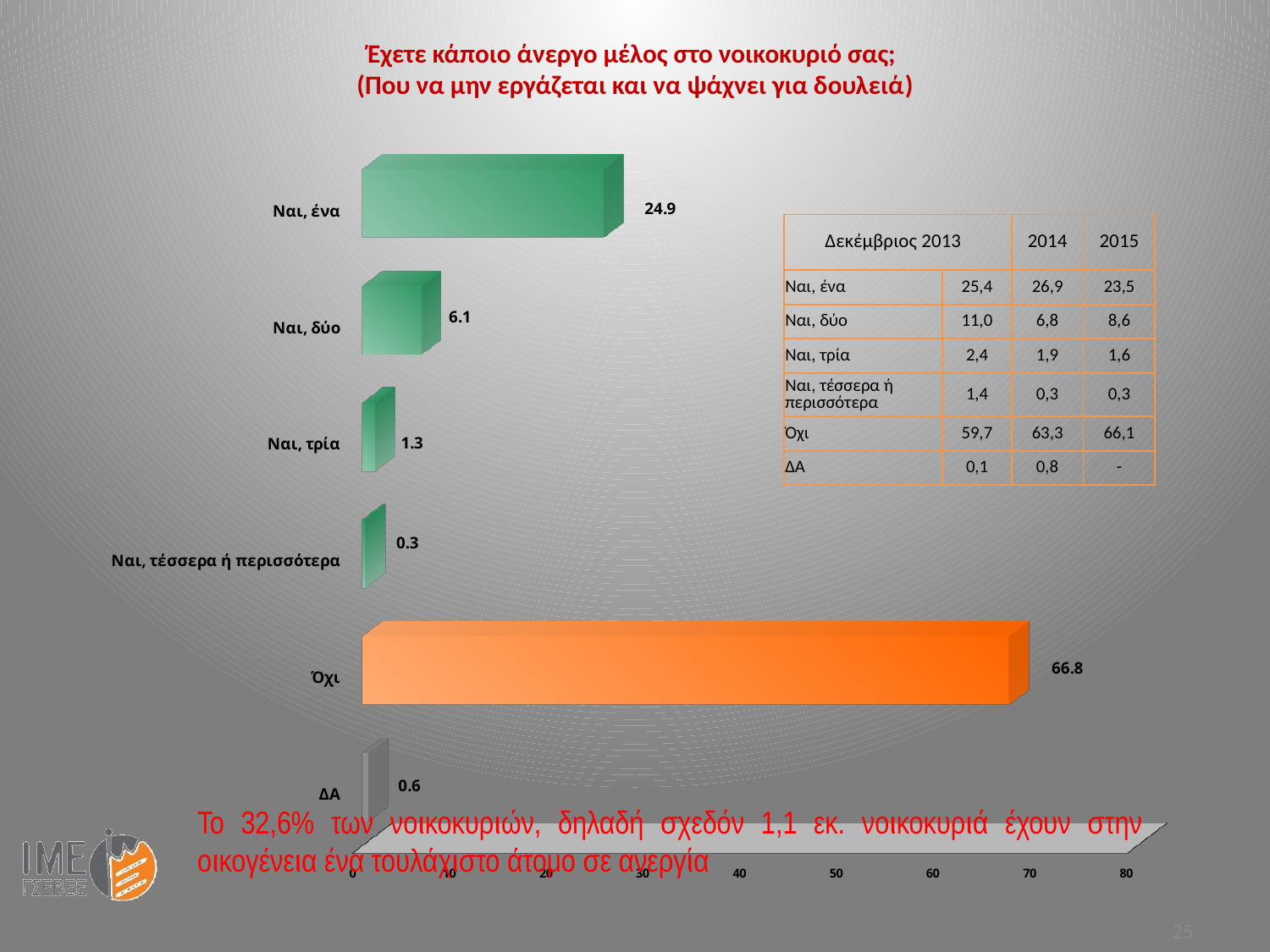
Is the value for Όχι greater or less than 60? greater How many categories are shown in the chart? 6 What is the value for Ναι, ένα? 24.9 What kind of chart is shown on the slide? bar chart Which category has the highest value? Όχι Which is larger, the value for Ναι, τρία or the value for ΔΑ? Ναι, τρία What colour is the bar for Όχι? orange What is the value for Ναι, δύο? 6.1 What is the value for Όχι? 66.8 What is the difference between the values for Όχι and Ναι, ένα? 41.9 What is the value for Ναι, τέσσερα ή περισσότερα? 0.3 Which category has the lowest value? Ναι, τέσσερα ή περισσότερα